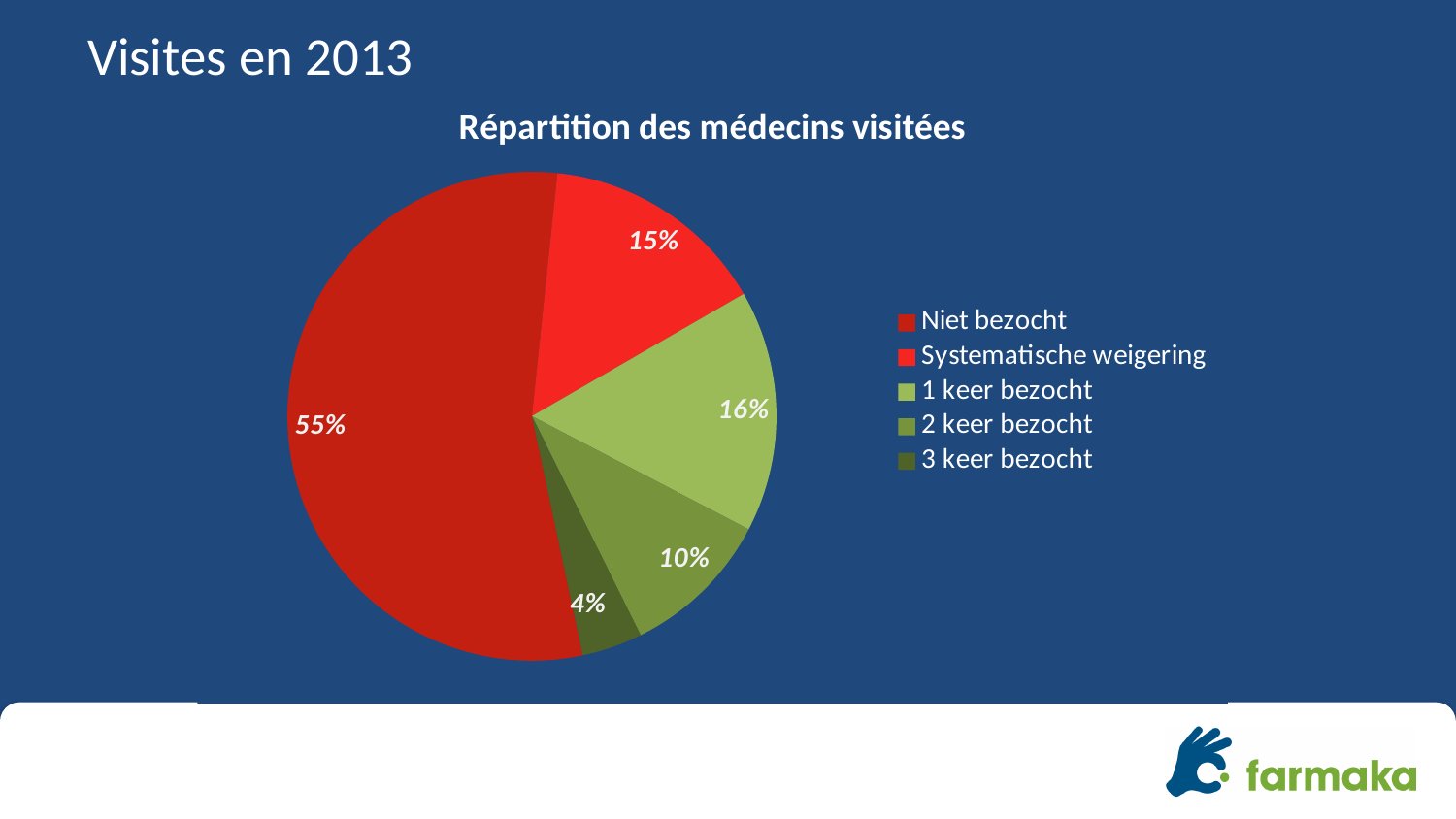
What is the value shown for "3 keer bezocht"? 4% What is the value shown for "2 keer bezocht"? 10% What kind of chart is shown on the slide? Pie chart Which category has the smallest slice of the pie? 3 keer bezocht Which is larger, the share for "2 keer bezocht" or the share for "Systematische weigering"? Systematische weigering What is the title of the chart? Répartition des médecins visitées What is the value shown for "Systematische weigering"? 15% What share of the pie does "Niet bezocht" represent? 55% How many categories does the legend list? 5 Which category has the largest slice of the pie? Niet bezocht What is the value shown for "1 keer bezocht"? 16% What is the difference between the shares of "Niet bezocht" and "1 keer bezocht"? 39%